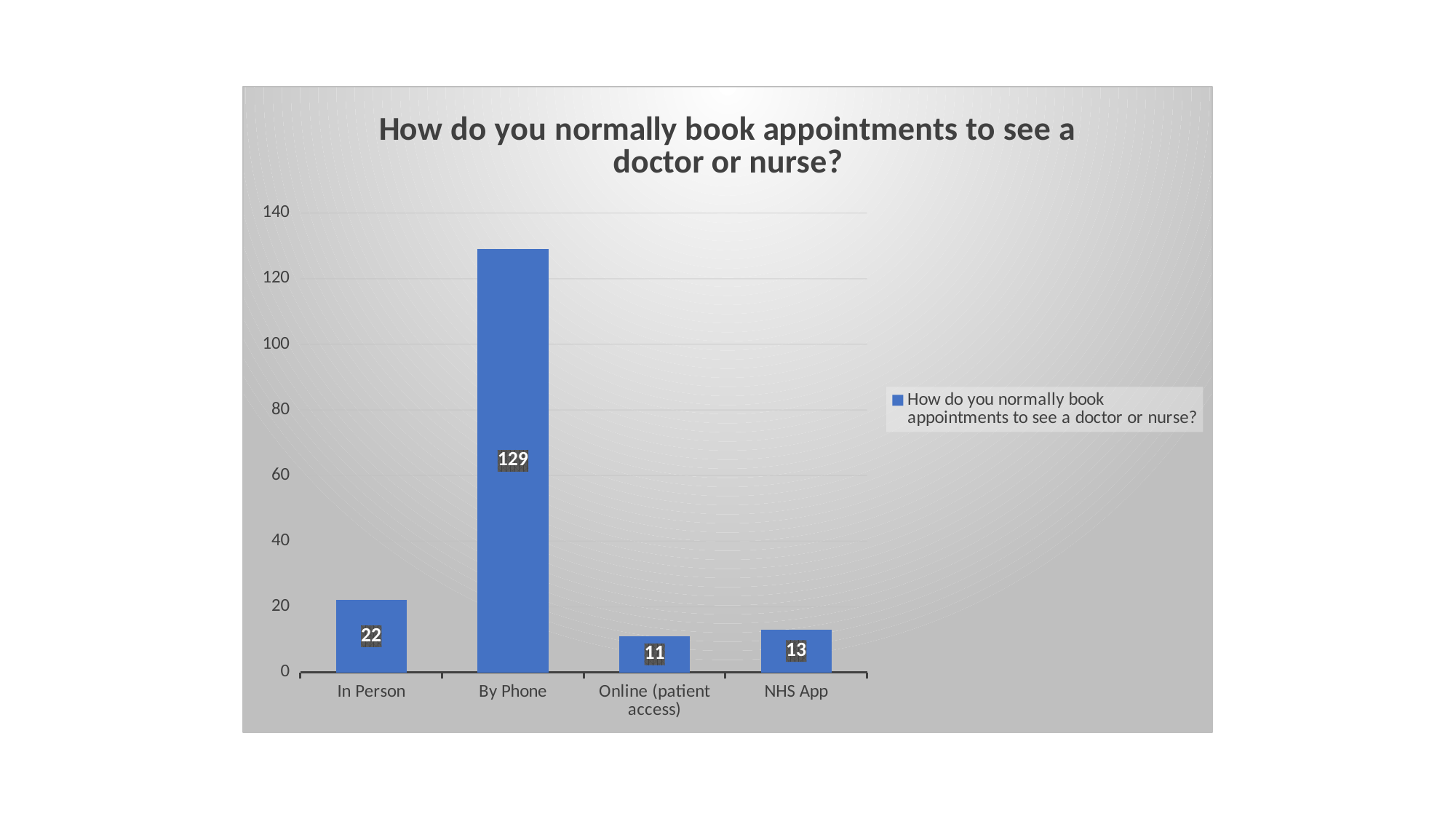
What is the value for Online (patient access)? 11 What is the value for By Phone? 129 What is the value for NHS App? 13 Which category has the highest value? By Phone What is the difference between the values for By Phone and In Person? 107 Is the value for By Phone greater or less than 120? greater What is the title of the chart? How do you normally book appointments to see a doctor or nurse? Which is larger, the value for In Person or the value for NHS App? In Person Which category has the lowest value? Online (patient access) What is the value for In Person? 22 How many categories are shown on the x axis? 4 What kind of chart is shown on the slide? Bar chart